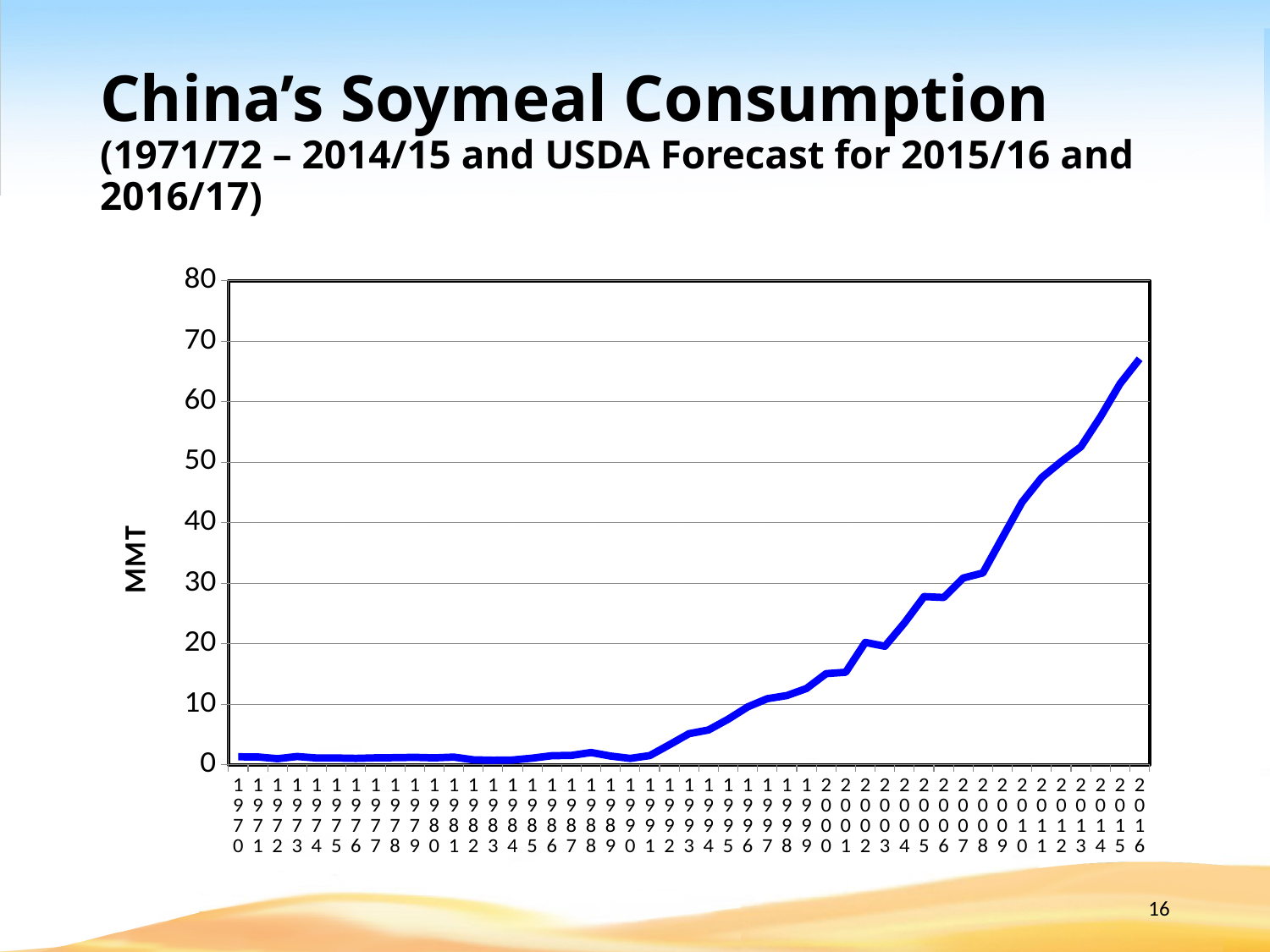
Does China's soymeal consumption generally rise or fall from 1970 to 2016? rise What kind of chart is shown on the slide? line chart Is the value for 1990 greater or less than 10? less Is the value for 2000 greater or less than 10? greater Which year has the larger soymeal consumption, 2000 or 1990? 2000 Is the value for 2011 greater or less than 50? less How many years are plotted along the x axis of the chart? 47 Which year has the highest soymeal consumption on the chart? 2016 What is the title of the chart on the slide? China's Soymeal Consumption What is the label on the vertical axis of the chart? MMT